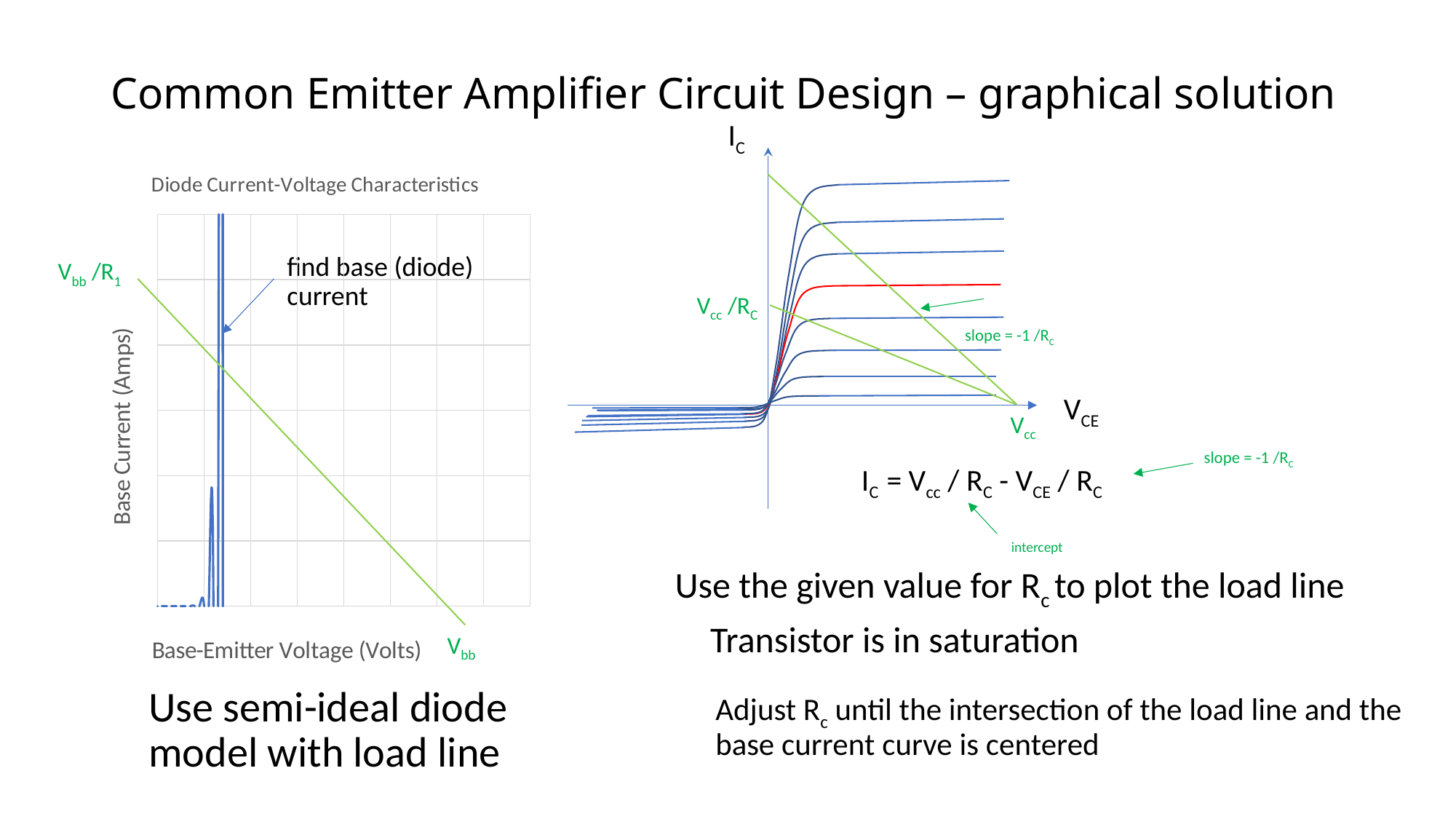
In the I_C versus V_CE chart on the right, what colour is the single highlighted characteristic curve? red How many green load lines are drawn on the I_C versus V_CE chart on the right? 2 In the I_C versus V_CE chart on the right, do the green load lines rise or fall as V_CE increases? fall In the 'Diode Current-Voltage Characteristics' chart, does the green load line rise or fall as Base-Emitter Voltage increases? fall How many transistor characteristic curves (blue and red together) are drawn on the I_C versus V_CE chart on the right? 8 In the 'Diode Current-Voltage Characteristics' chart, does the blue diode curve rise or fall as Base-Emitter Voltage increases? rise What kind of chart is the I_C versus V_CE chart on the right? line chart What kind of chart is the 'Diode Current-Voltage Characteristics' chart on the left? line chart What is the title of the chart on the left of the slide? Diode Current-Voltage Characteristics